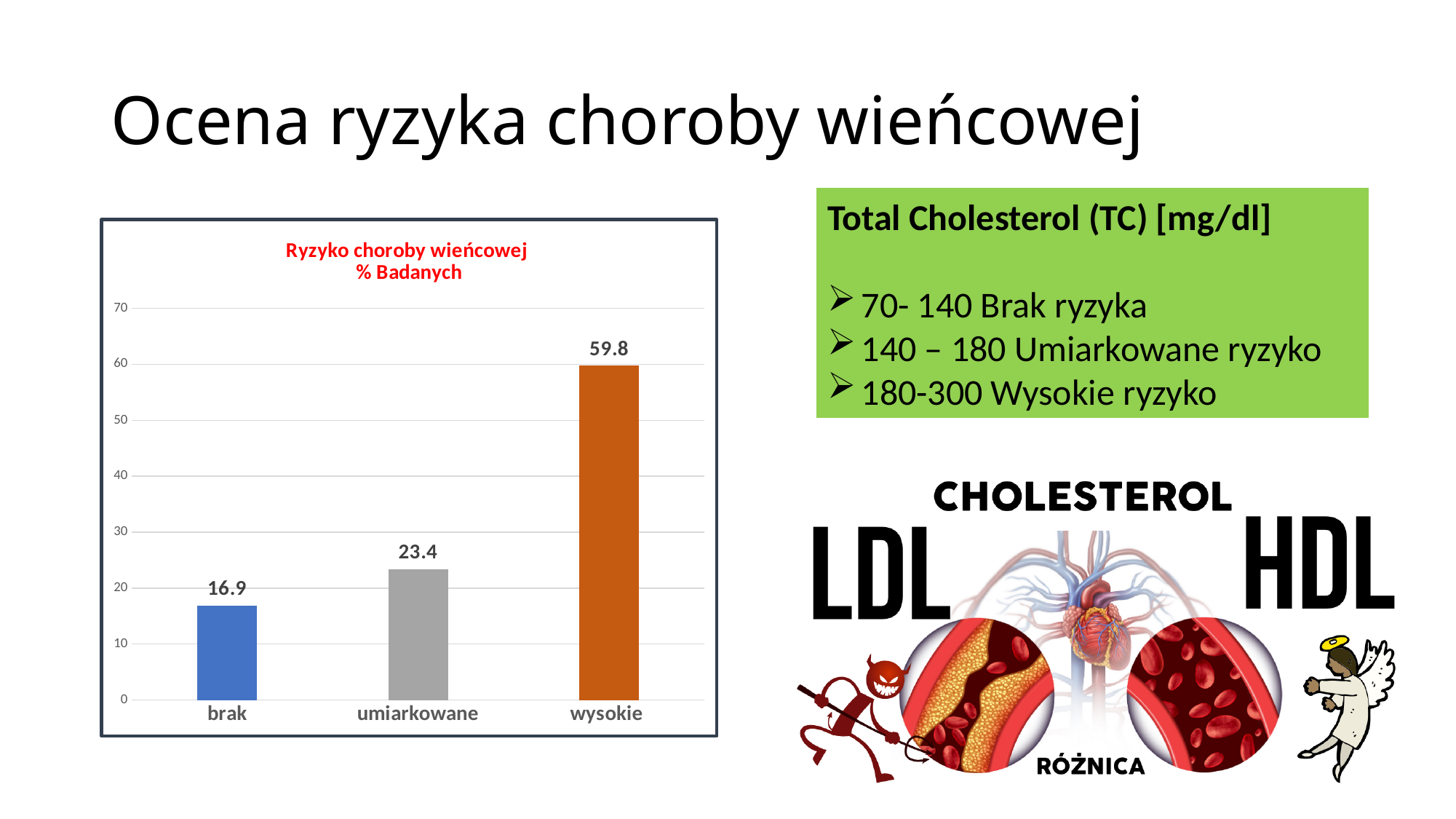
What is the difference between the values for 'wysokie' and 'umiarkowane'? 36.4 Which category has the lowest value? brak What kind of chart is shown on the slide? bar chart What is the value for the 'wysokie' category? 59.8 What is the value for the 'umiarkowane' category? 23.4 Which is larger, the value for 'brak' or the value for 'umiarkowane'? umiarkowane What is the title of the chart? Ryzyko choroby wieńcowej % Badanych What is the value for the 'brak' category? 16.9 How many categories are shown in the chart? 3 What is the difference between the values for 'umiarkowane' and 'brak'? 6.5 Which category has the highest value? wysokie Is the value for 'wysokie' greater or less than 50? greater